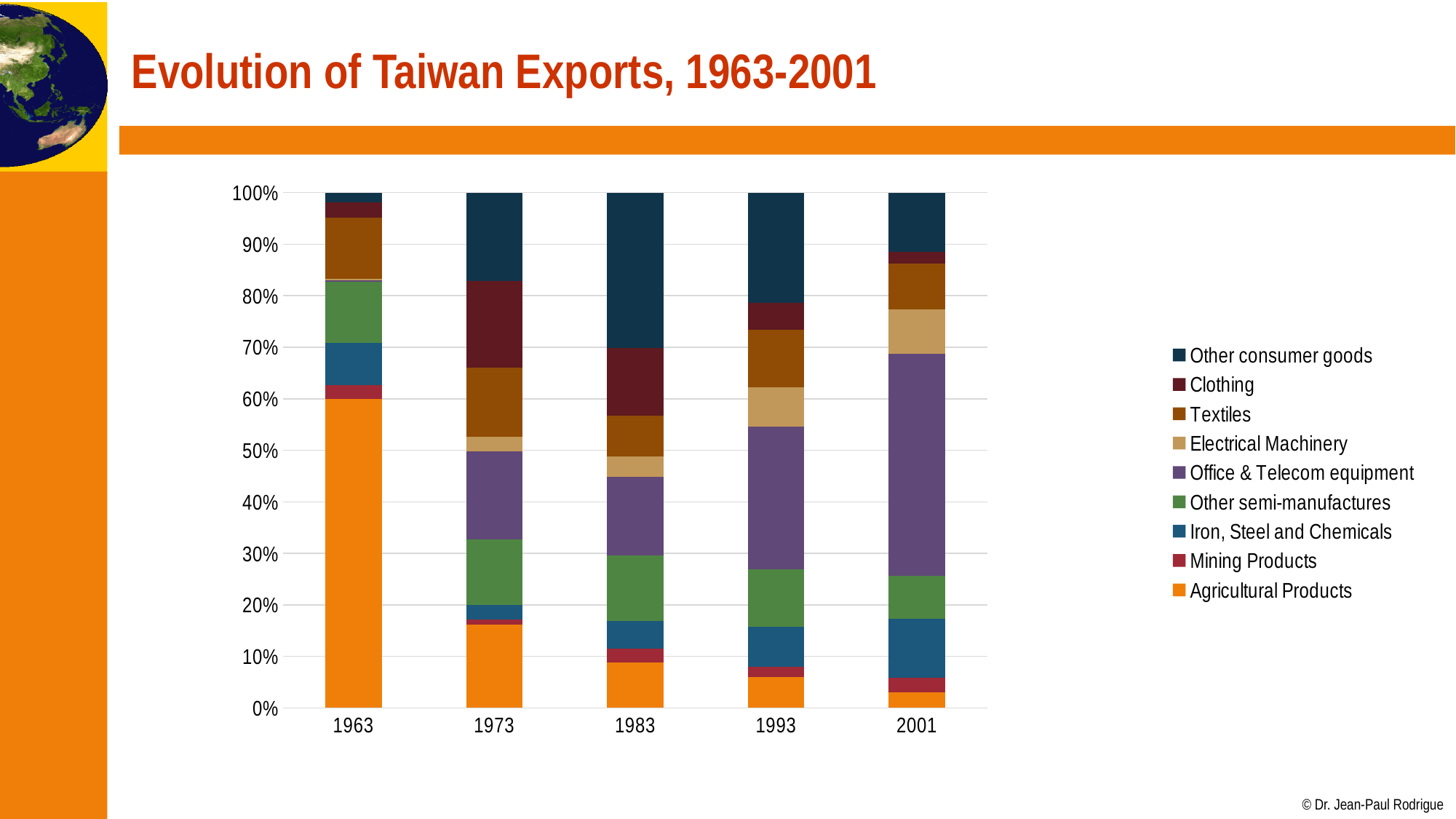
Is the share of Office & Telecom equipment in 2001 greater or less than 30%? greater Does the share of Agricultural Products rise or fall from 1963 to 2001? fall Is the share of Agricultural Products in 1963 greater or less than 50%? greater What kind of chart is shown on the slide? Stacked bar chart Is the share of Agricultural Products in 2001 greater or less than 10%? less Which is larger, the share of Office & Telecom equipment in 1973 or in 2001? 2001 How many series does the chart legend list? 9 Which year has the largest share of Agricultural Products? 1963 Which legend entry is shown in orange? Agricultural Products What is the title of the slide's chart? Evolution of Taiwan Exports, 1963-2001 Which year has the smallest share of Agricultural Products? 2001 How many years are shown along the x axis of the chart? 5